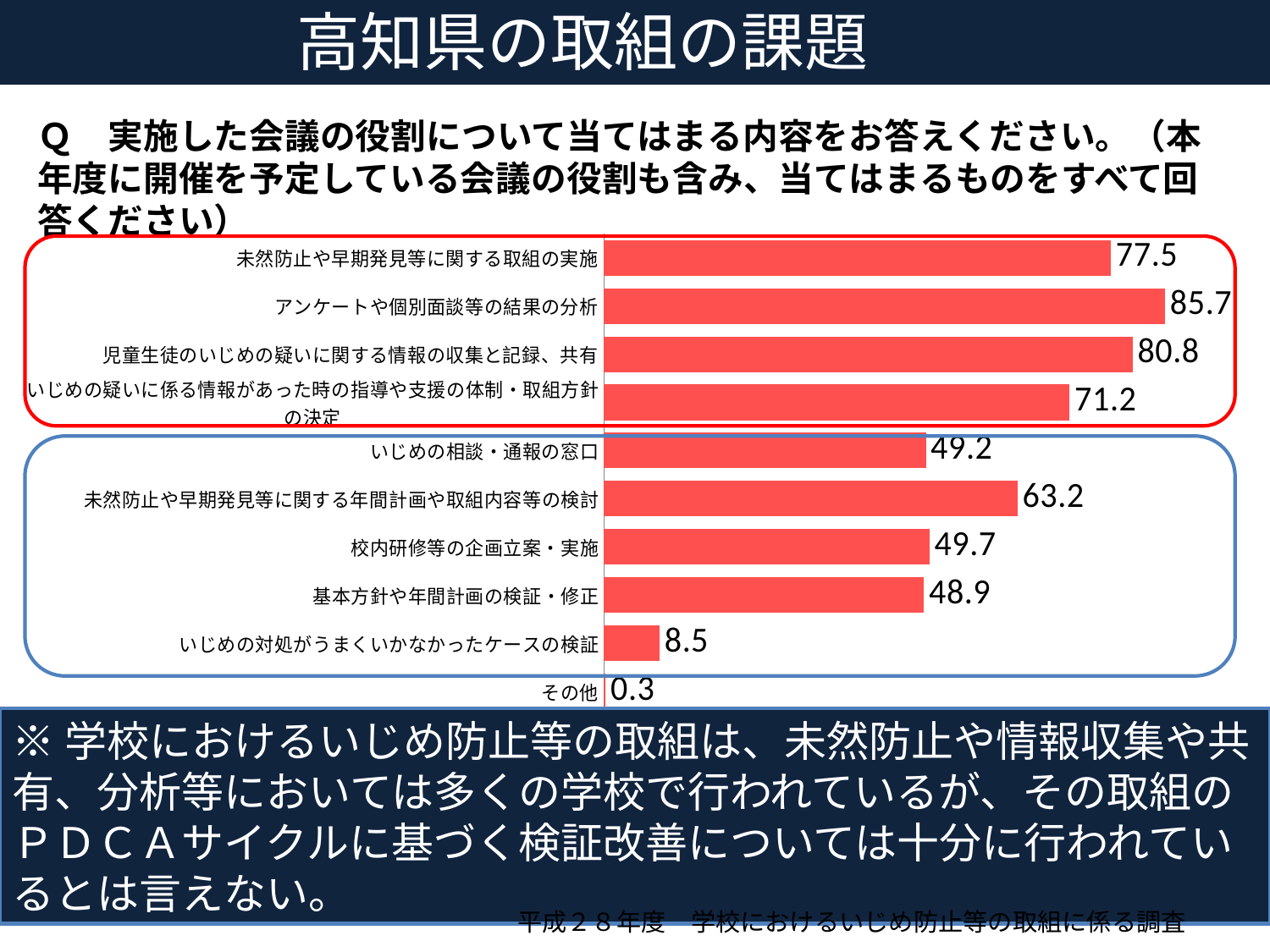
How many categories are shown in the chart? 10 What is the difference between 「児童生徒のいじめの疑いに関する情報の収集と記録、共有」 and 「いじめの相談・通報の窓口」? 31.6 What is the value for 「いじめの対処がうまくいかなかったケースの検証」? 8.5 What is the value for 「その他」? 0.3 What is the value for 「校内研修等の企画立案・実施」? 49.7 Which category has the lowest value? その他 Which is larger, 「未然防止や早期発見等に関する年間計画や取組内容等の検討」 or 「基本方針や年間計画の検証・修正」? 未然防止や早期発見等に関する年間計画や取組内容等の検討 What is the difference between 「未然防止や早期発見等に関する取組の実施」 and 「いじめの疑いに係る情報があった時の指導や支援の体制・取組方針の決定」? 6.3 What is the value for 「アンケートや個別面談等の結果の分析」? 85.7 Which category has the highest value? アンケートや個別面談等の結果の分析 What colour are the bars in the chart? Red What kind of chart is shown on the slide? Bar chart